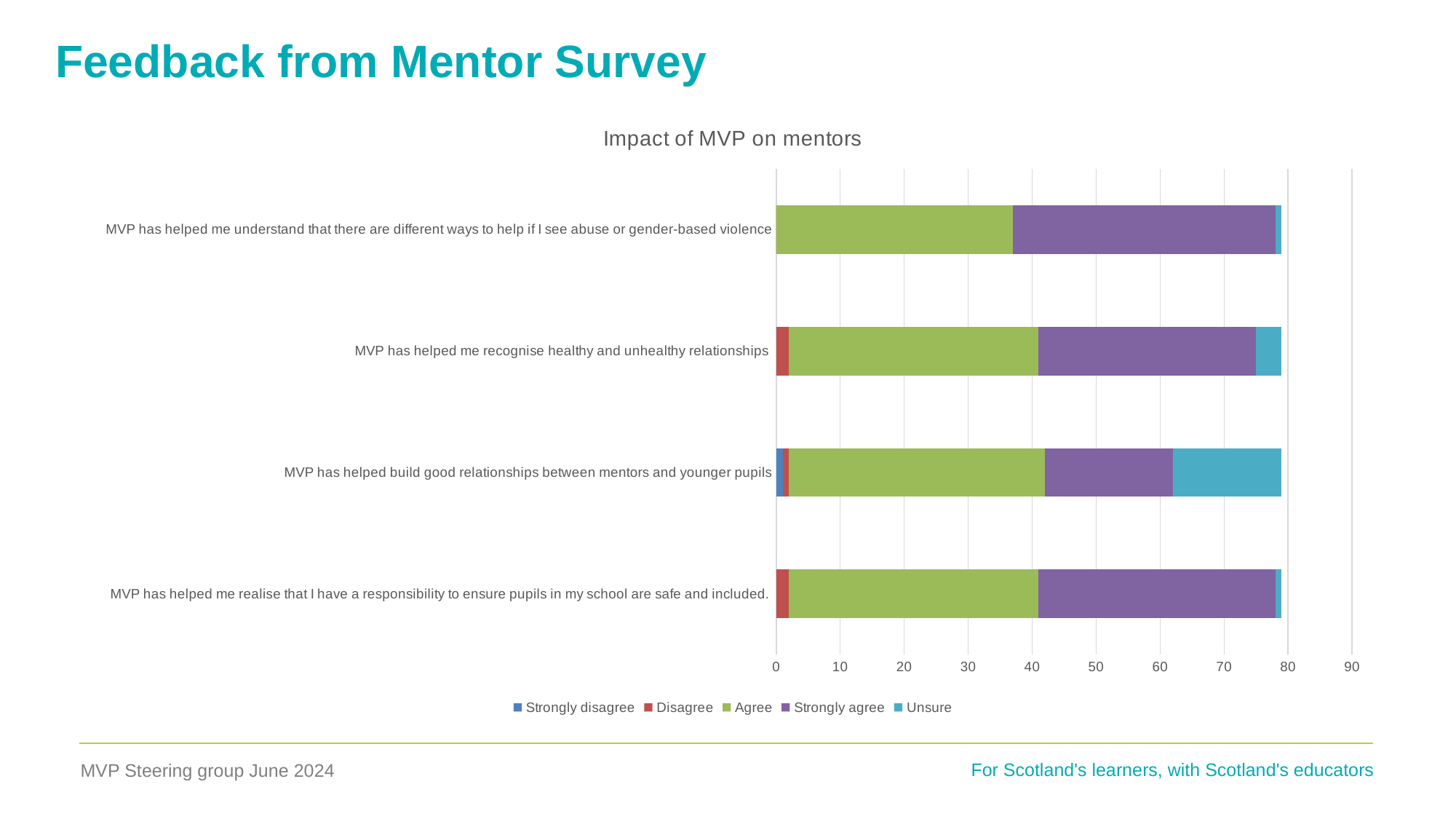
Which statement has the smallest Strongly agree segment? MVP has helped build good relationships between mentors and younger pupils Is the Strongly agree segment larger for 'MVP has helped me understand that there are different ways to help if I see abuse or gender-based violence' or for 'MVP has helped build good relationships between mentors and younger pupils'? MVP has helped me understand that there are different ways to help if I see abuse or gender-based violence Which statement has the largest Unsure segment? MVP has helped build good relationships between mentors and younger pupils Which series is shown in green in the chart? Agree Is the total bar length for 'MVP has helped me recognise healthy and unhealthy relationships' greater or less than 70? greater Is the Unsure segment larger for 'MVP has helped build good relationships between mentors and younger pupils' or for 'MVP has helped me recognise healthy and unhealthy relationships'? MVP has helped build good relationships between mentors and younger pupils How many series does the legend list? 5 What kind of chart is shown on the slide? Stacked bar chart Which statement is the only one with a Strongly disagree segment? MVP has helped build good relationships between mentors and younger pupils How many survey statements (categories) are plotted in the chart? 4 What is the title of the chart? Impact of MVP on mentors Is the Strongly agree value for 'MVP has helped build good relationships between mentors and younger pupils' greater or less than 30? less